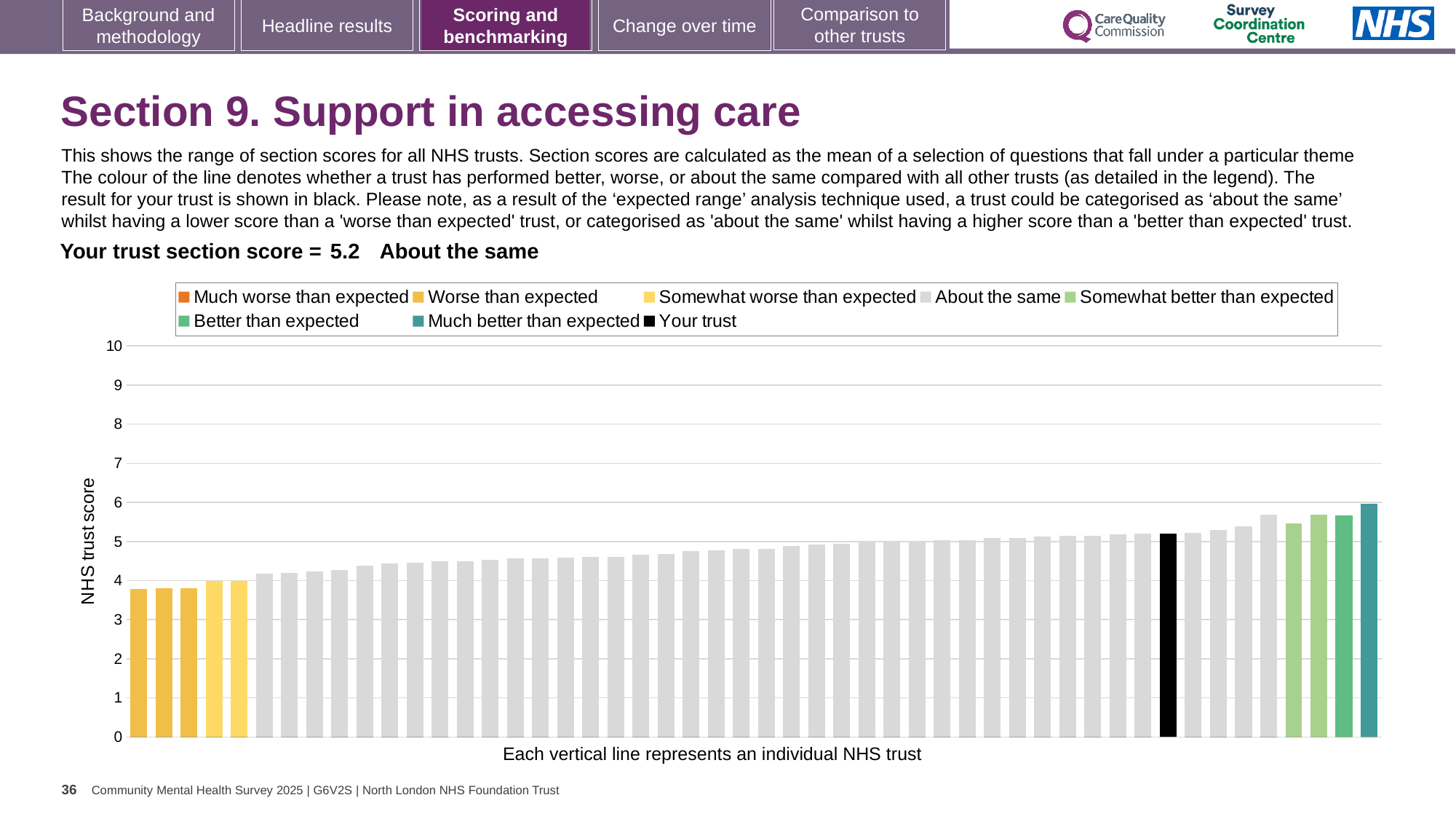
Do the bar values rise or fall from left to right along the x axis? rise Which category is your trust placed in according to the text above the chart? About the same How many entries does the chart legend list? 8 What is the section score for your trust shown on the slide? 5.2 What is the label of the y axis? NHS trust score Is the value of the leftmost bar greater or less than 4? less Which is larger, the leftmost bar or the rightmost bar? the rightmost bar Is the value of the rightmost bar greater or less than 5? greater What colour is the bar representing your trust? black How many bars are coloured as 'Much better than expected'? 1 What type of chart is shown on the slide? bar chart Is the value for your trust (the black bar) greater or less than 5? greater